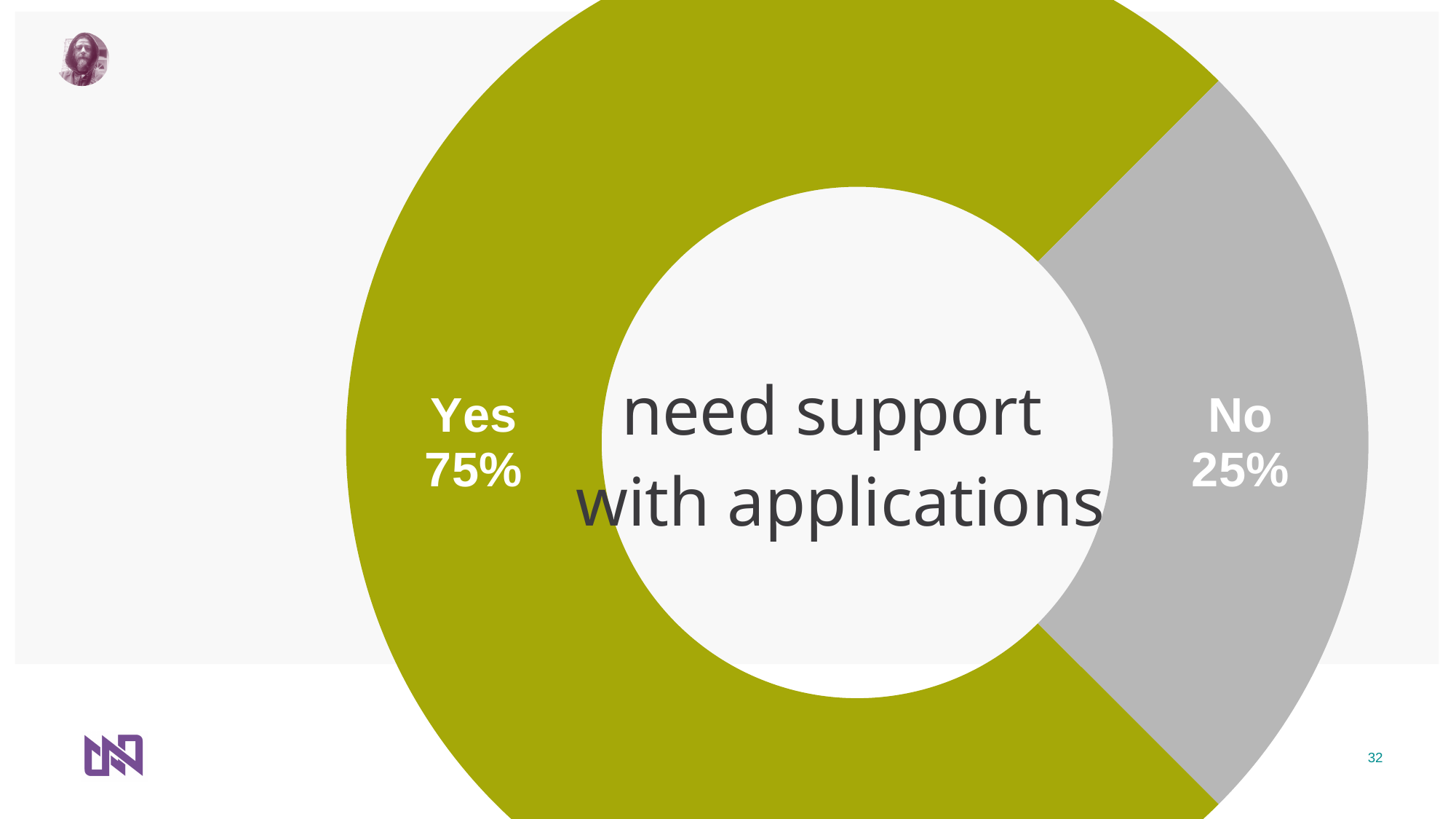
Which category has the largest share of the chart? Yes What percentage of respondents answered Yes to needing support with applications? 75% What text is shown in the centre of the doughnut chart? need support with applications How many categories are shown in the chart? 2 What is the difference in percentage points between the Yes and No shares? 50 Which is larger, the Yes share or the No share? Yes What share of the chart does the Yes slice represent? 75% What colour is the Yes segment of the chart? Olive green What kind of chart is shown on the slide? Doughnut chart What percentage of respondents answered No to needing support with applications? 25% Which category has the smallest share of the chart? No